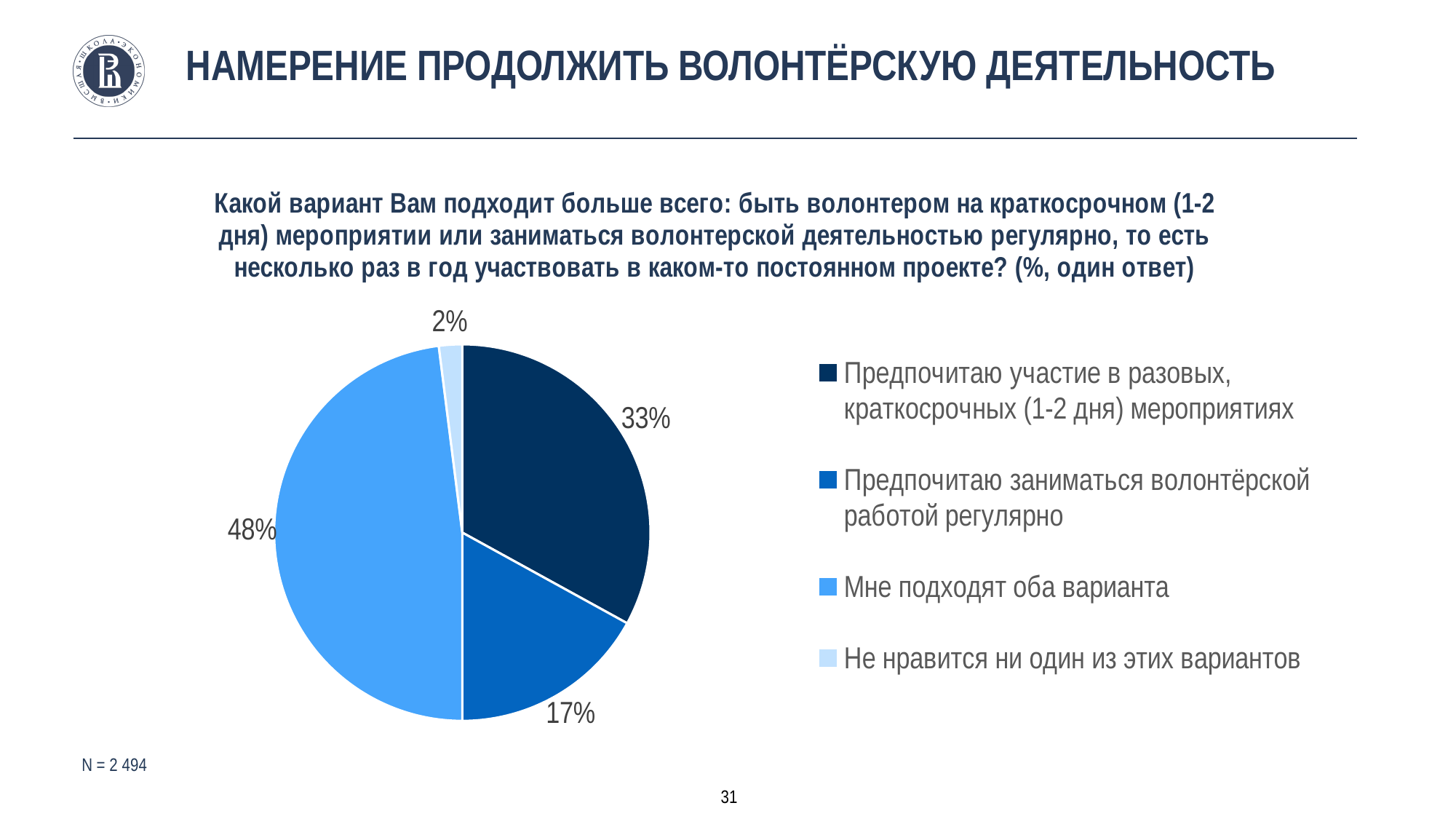
How many slices does the pie chart have? 4 Which answer option has the largest share of the pie? Мне подходят оба варианта What kind of chart is shown on the slide? pie chart Which answer option has the smallest share of the pie? Не нравится ни один из этих вариантов Which is larger: the share for "Предпочитаю участие в разовых, краткосрочных (1-2 дня) мероприятиях" or for "Предпочитаю заниматься волонтёрской работой регулярно"? Предпочитаю участие в разовых, краткосрочных (1-2 дня) мероприятиях What share of respondents chose "Не нравится ни один из этих вариантов"? 2% What is the sample size (N) stated on the slide? N = 2 494 What share of respondents chose "Предпочитаю заниматься волонтёрской работой регулярно"? 17% What share of respondents chose "Предпочитаю участие в разовых, краткосрочных (1-2 дня) мероприятиях"? 33% How many entries does the legend list? 4 What is the difference in percentage points between "Мне подходят оба варианта" and "Предпочитаю участие в разовых, краткосрочных (1-2 дня) мероприятиях"? 15 What share of respondents chose "Мне подходят оба варианта"? 48%